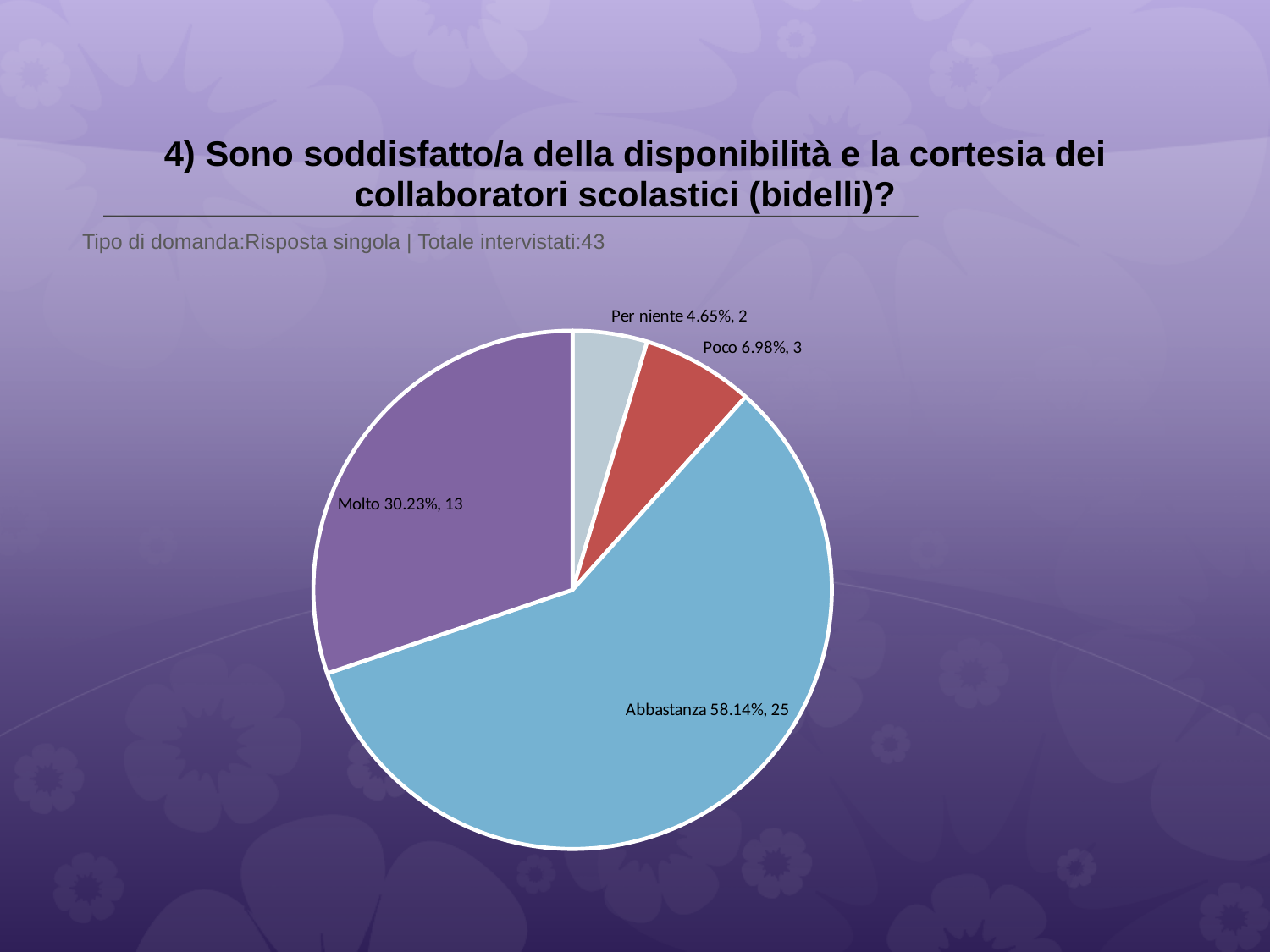
What percentage share does the Per niente slice have? 4.65% What percentage share does the Abbastanza slice have? 58.14% What kind of chart is shown on the slide? pie chart Which has more respondents, Poco or Per niente? Poco Which response category has the largest slice? Abbastanza What is the difference in number of respondents between Abbastanza and Molto? 12 How many respondents answered Molto? 13 How many respondents answered Poco? 3 How many slices does the pie chart have? 4 What is the total number of respondents across all slices? 43 What colour is the Abbastanza slice? blue Which response category has the smallest slice? Per niente